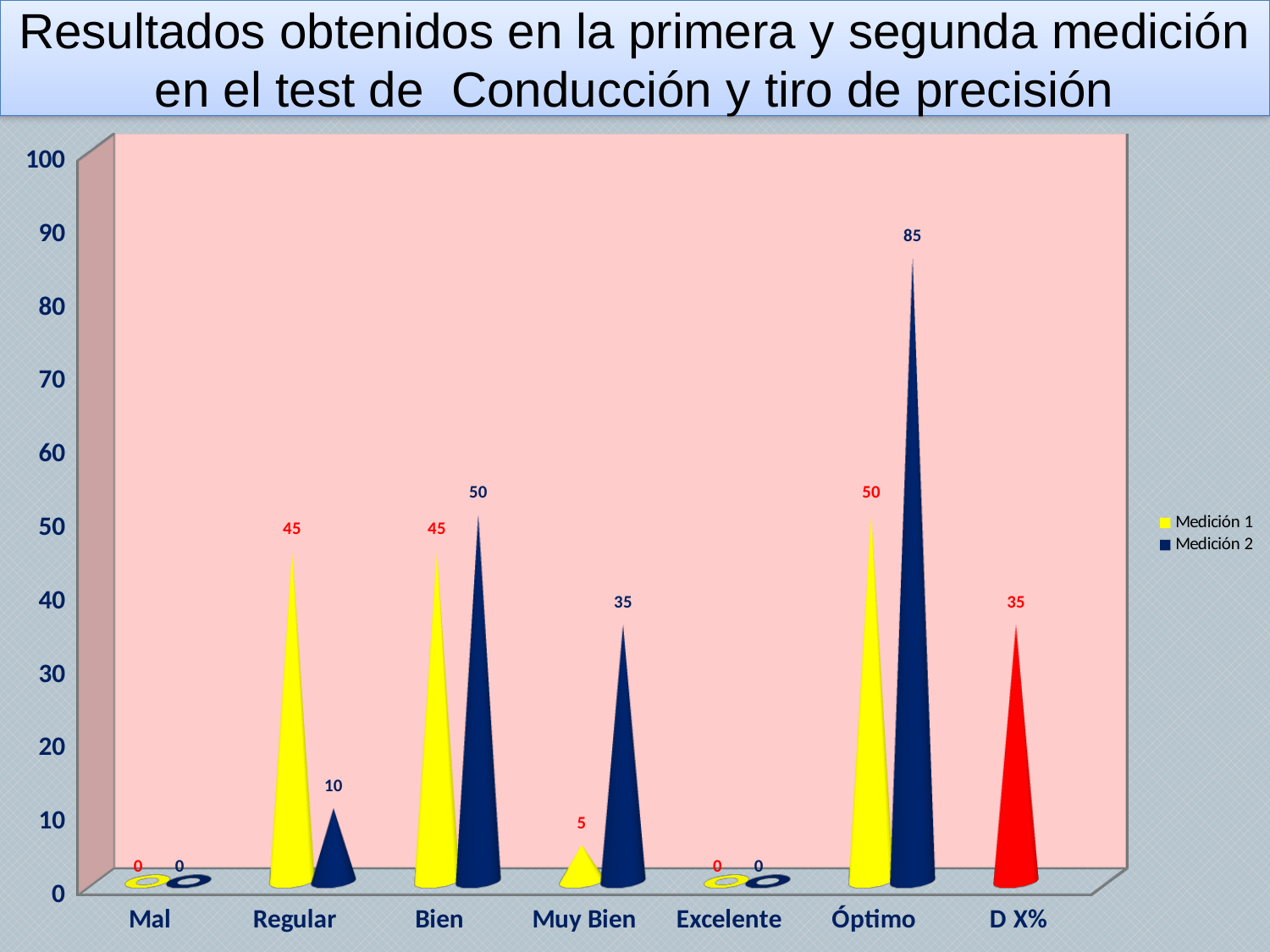
What is the difference between Medición 1 and Medición 2 for Regular? 35 What is the value of Medición 2 for Óptimo? 85 How many series does the legend list? 2 What colour represents Medición 1 in the legend? Yellow What is the difference between Medición 2 and Medición 1 for Óptimo? 35 What is the value of Medición 2 for Muy Bien? 35 Which category has the highest value for Medición 1? Óptimo What is the value of Medición 1 for Muy Bien? 5 Which category has the highest value for Medición 2? Óptimo How many categories are shown on the x axis? 7 For Bien, which is larger, Medición 1 or Medición 2? Medición 2 What is the value of Medición 1 for Regular? 45